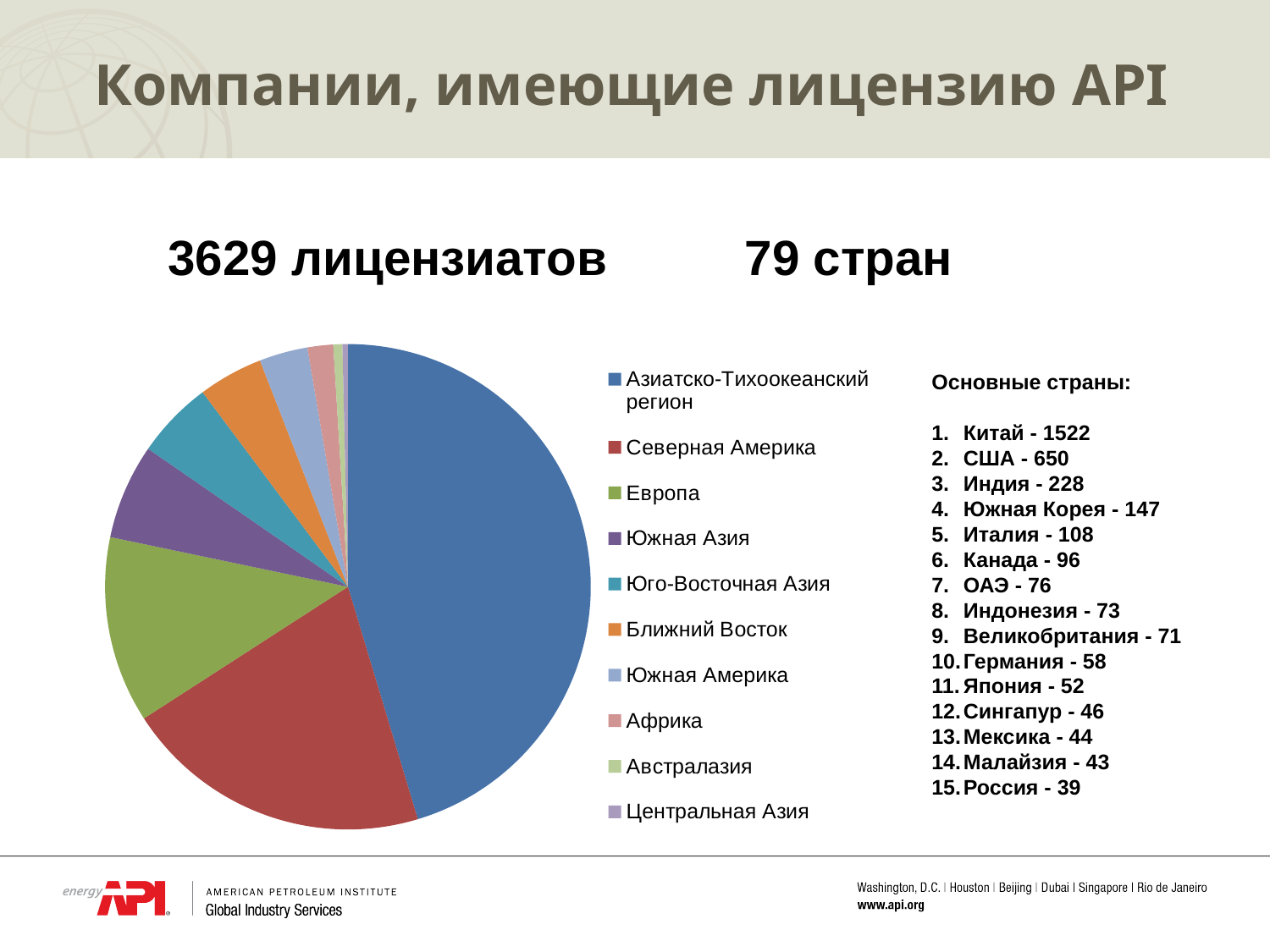
Which category has the largest slice of the pie chart? Азиатско-Тихоокеанский регион What kind of chart is shown on the slide? pie chart Which slice is larger in the pie chart, Европа or Южная Азия? Европа What is the title of the slide containing the pie chart? Компании, имеющие лицензию API Which slice is larger in the pie chart, Южная Азия or Африка? Южная Азия Which slice is larger in the pie chart, Азиатско-Тихоокеанский регион or Северная Америка? Азиатско-Тихоокеанский регион Which category in the pie chart's legend is shown in blue? Азиатско-Тихоокеанский регион How many categories does the pie chart's legend list? 10 Which category is the second-largest slice of the pie chart? Северная Америка